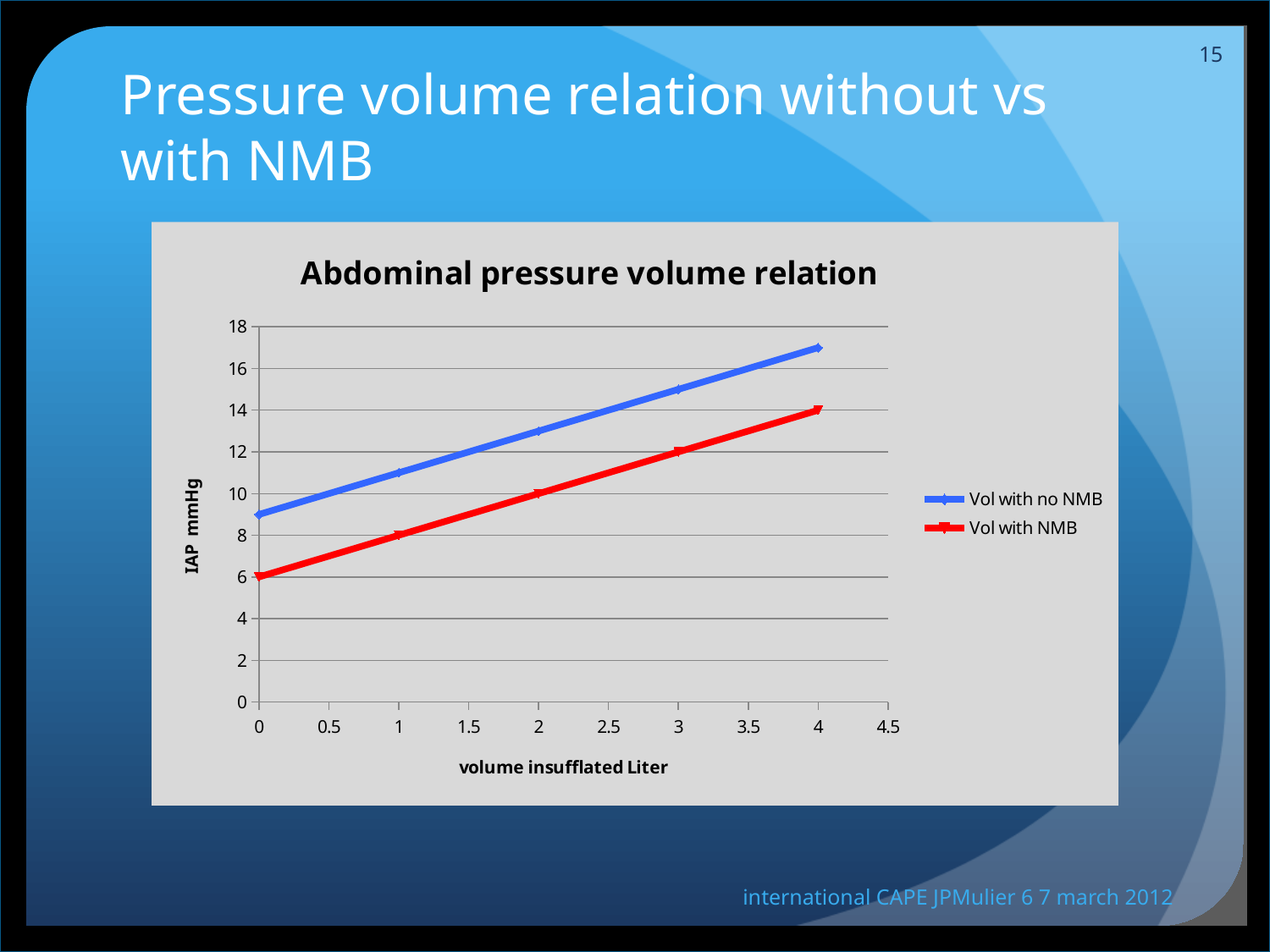
Which series is drawn in red? Vol with NMB What is the difference between the Vol with NMB values at 4 liters and at 0 liters? 8 Is the value for Vol with no NMB at 0 liters greater or less than 10? less What kind of chart is shown on the slide? line chart Do the IAP values for Vol with NMB rise or fall as the insufflated volume increases? rise What is the IAP value for Vol with NMB at 2 liters insufflated? 10 What is the title of the chart? Abdominal pressure volume relation At 3 liters insufflated, which series has the higher IAP, Vol with no NMB or Vol with NMB? Vol with no NMB What is the IAP value for Vol with NMB at 4 liters insufflated? 14 What is the IAP value for Vol with NMB at 0 liters insufflated? 6 Is the value for Vol with no NMB at 4 liters greater or less than 16? greater How many series does the legend list? 2